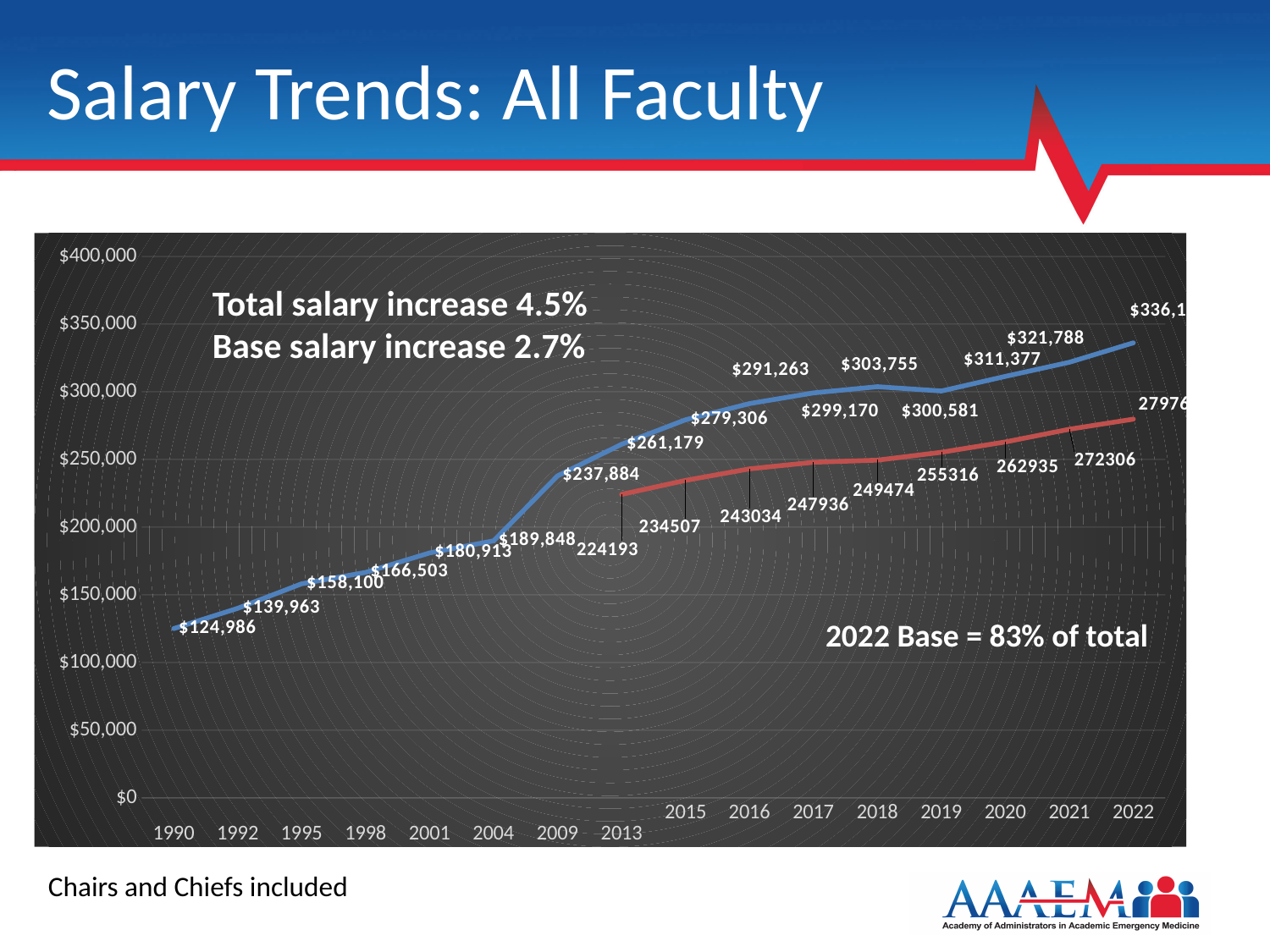
Is the value of the red line for 2022 greater or less than $300,000? less What is the difference between the red line's values for 2021 and 2013? 48113 Is the value of the blue line for 2022 greater or less than $300,000? greater What is the value of the blue line for 1990? $124,986 What kind of chart is shown on the slide? line chart In which year does the blue line reach its highest value? 2022 How many years are listed along the x axis of the chart? 16 According to the text on the chart, what is the total salary increase? 4.5% What is the value of the red line for 2021? 272306 In which year does the blue line have its lowest value? 1990 Do the values of the blue line generally rise or fall from 1990 to 2022? rise What is the value of the red line for 2013? 224193